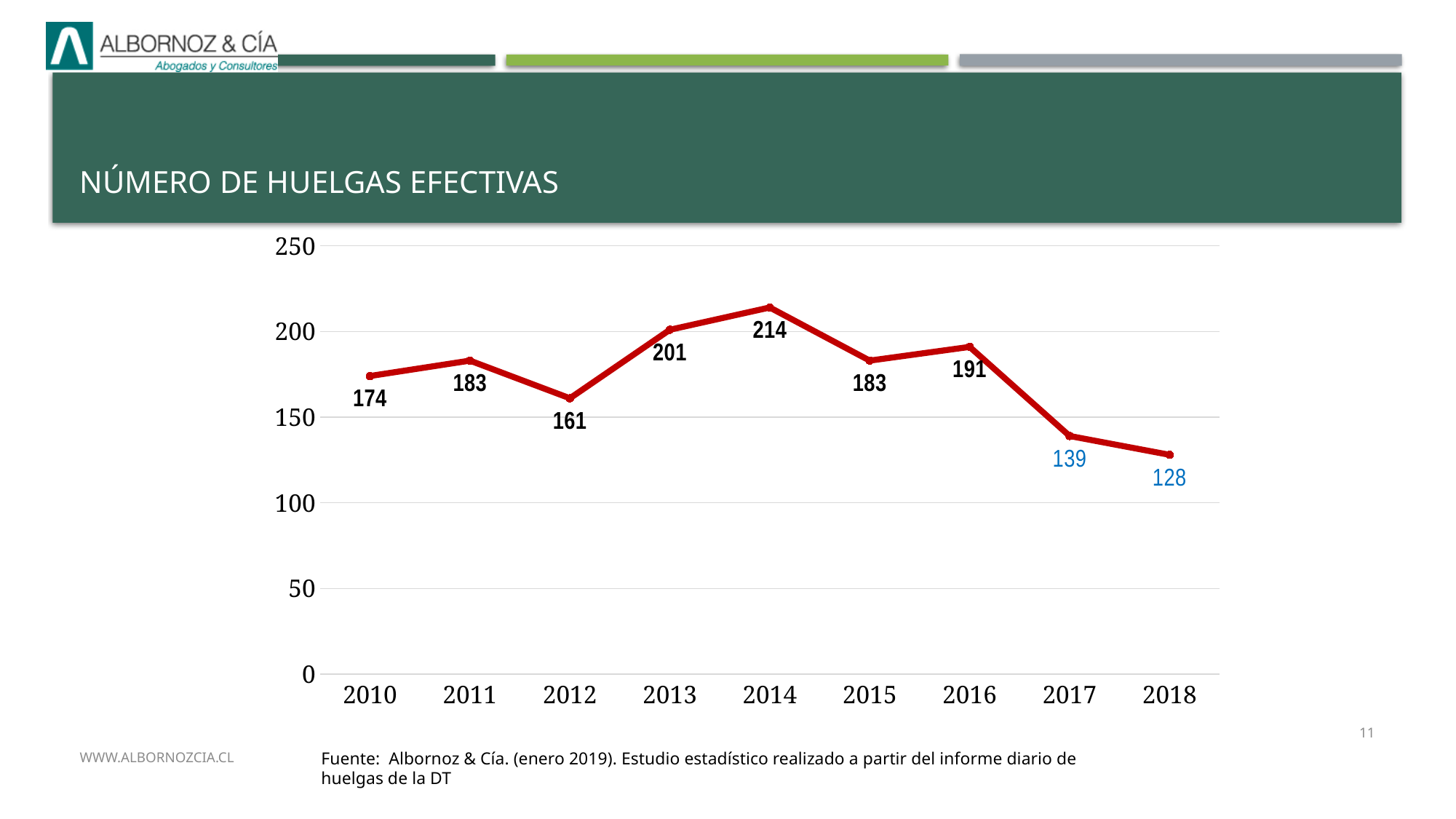
How many years are plotted on the chart? 9 What is the number of effective strikes in 2014? 214 What is the title of the chart? NÚMERO DE HUELGAS EFECTIVAS Which year has the lowest number of effective strikes? 2018 What is the difference between the values for 2016 and 2017? 52 What is the value for 2018? 128 What is the value for 2012? 161 What is the difference between the values for 2014 and 2018? 86 Is the value for 2017 greater or less than 150? less Which is larger, the value for 2013 or the value for 2015? 2013 What kind of chart is shown on the slide? line chart Which year has the highest number of effective strikes? 2014